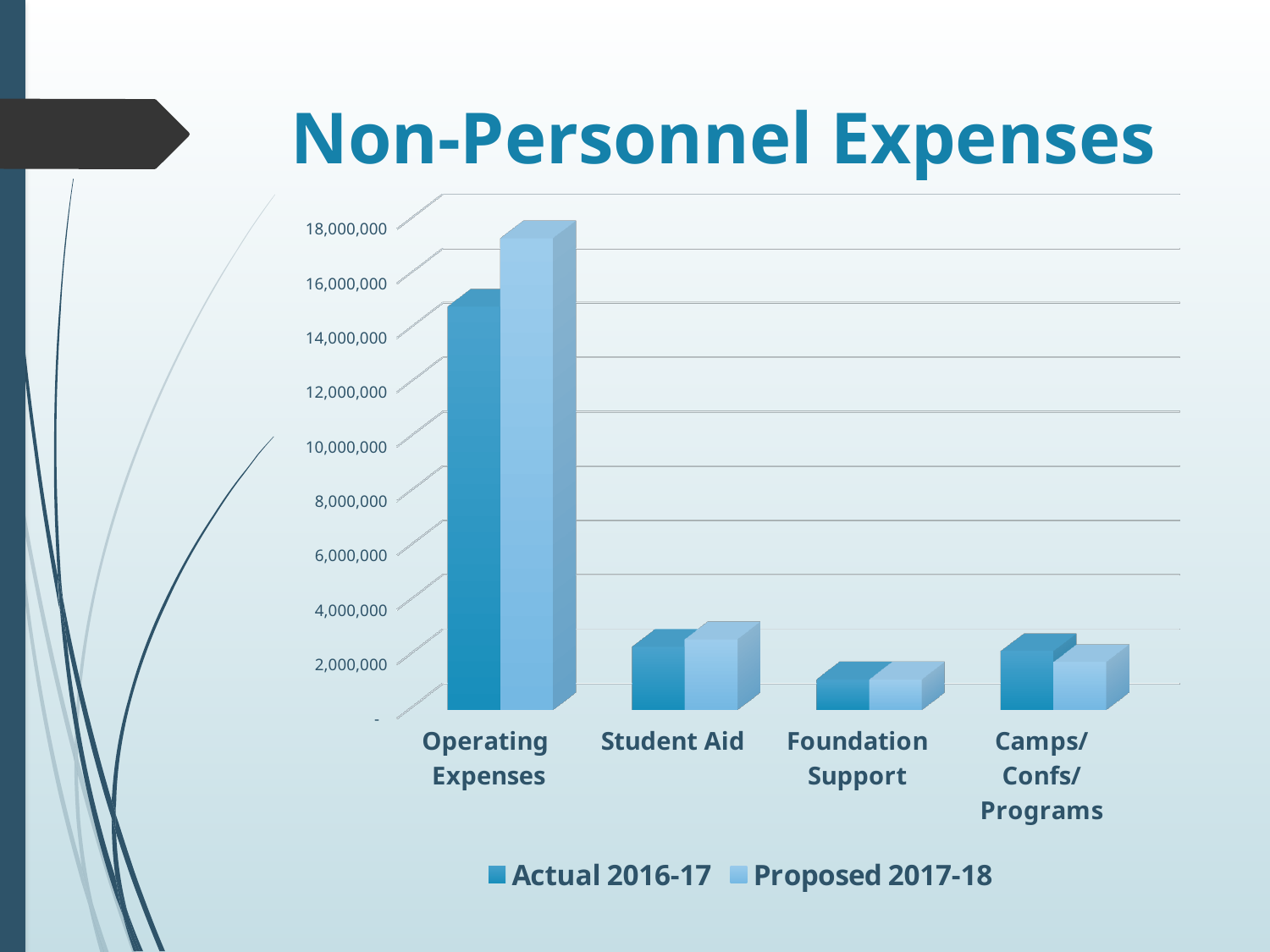
Is the Proposed 2017-18 value for Student Aid greater or less than 4,000,000? less What is the title of the chart? Non-Personnel Expenses For Operating Expenses, which is larger: Actual 2016-17 or Proposed 2017-18? Proposed 2017-18 What kind of chart is shown on the slide? Bar chart Is the Proposed 2017-18 value for Operating Expenses greater or less than 16,000,000? greater Which series is shown in the lighter blue colour in the legend? Proposed 2017-18 Which category has the highest values? Operating Expenses Is the Actual 2016-17 value for Foundation Support greater or less than 2,000,000? less How many series does the legend list? 2 How many categories are shown on the x axis? 4 Which category has the lowest values? Foundation Support